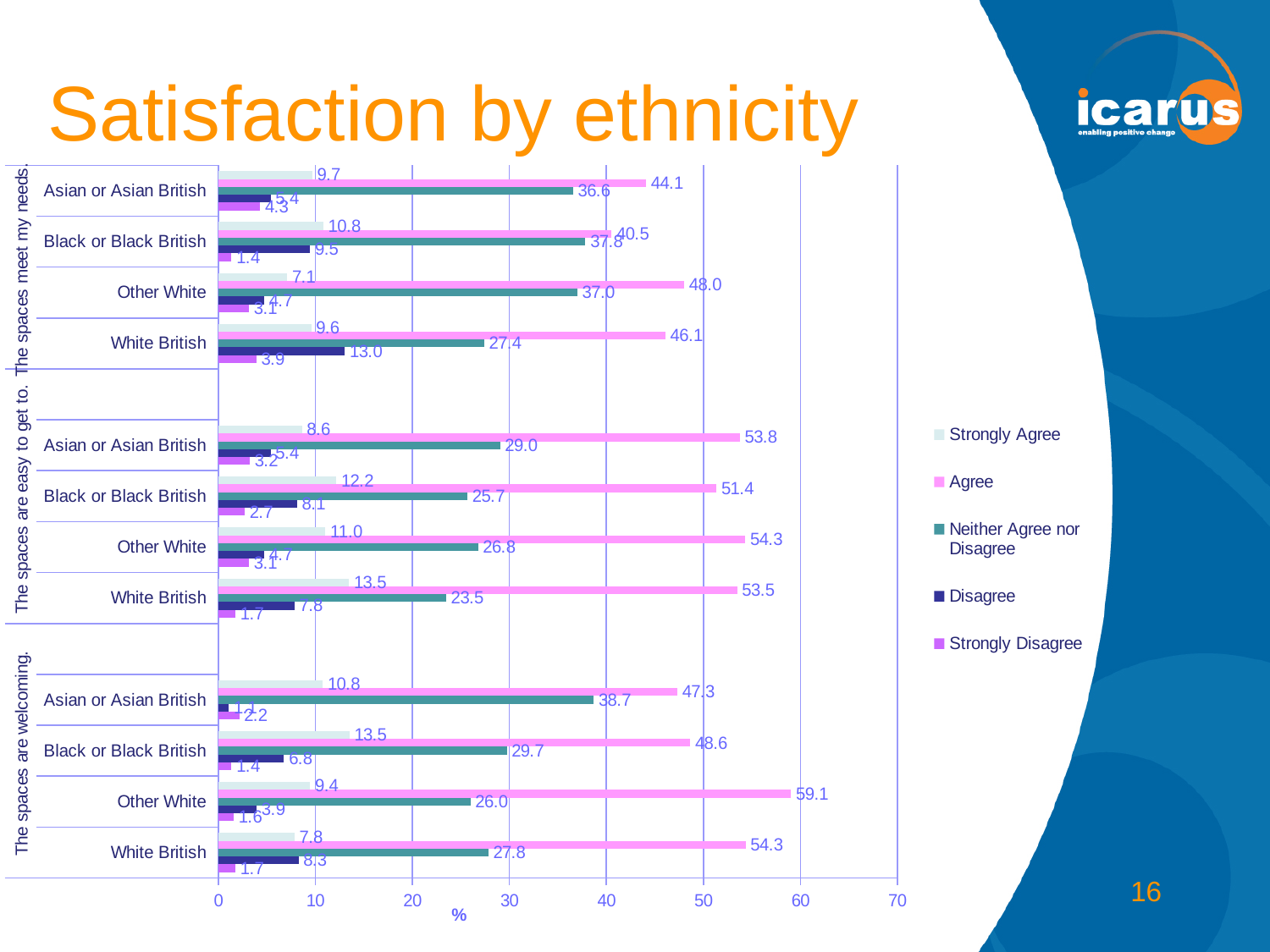
Across all three statements, which ethnicity group has the highest Agree value? Other White (The spaces are welcoming) For 'The spaces meet my needs', what is the Agree value for Other White? 48.0 For 'The spaces meet my needs', which is larger: the Neither Agree nor Disagree value for Black or Black British or for White British? Black or Black British For 'The spaces are easy to get to', what is the difference between the Agree values for Other White and Black or Black British? 2.9 What is the label on the horizontal axis of the chart? % What kind of chart is shown on the slide? bar chart How many statements (groups of ethnicity categories) are shown on the chart? 3 For 'The spaces are welcoming', is the Agree value for Other White greater or less than 50? greater For 'The spaces are welcoming', what is the Neither Agree nor Disagree value for Black or Black British? 29.7 For 'The spaces meet my needs', which ethnicity has the highest Disagree value? White British For 'The spaces are easy to get to', what is the Strongly Agree value for White British? 13.5 How many series does the legend list? 5